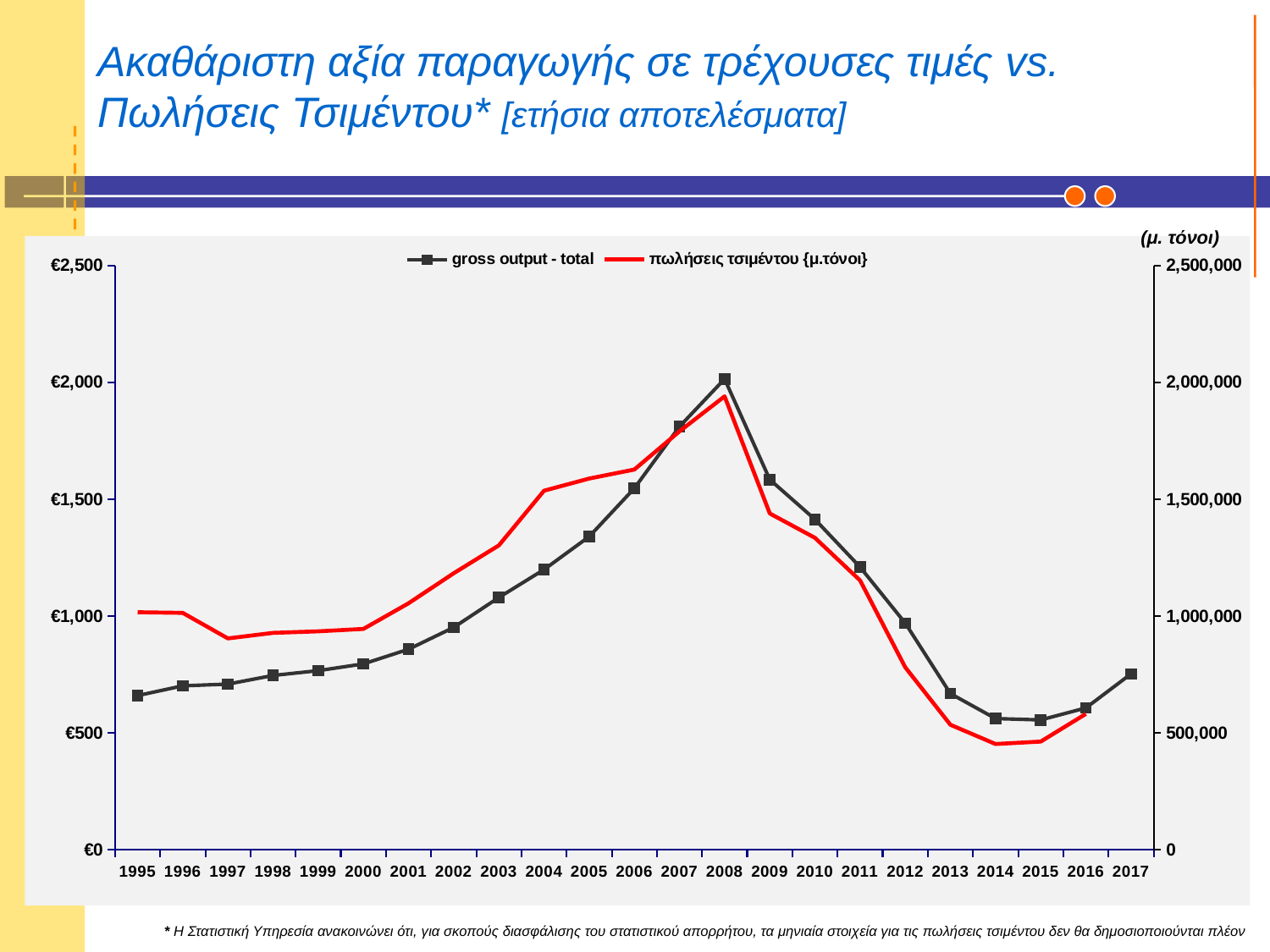
Is the gross output - total value for 1995 greater or less than €1,000? less Is the πωλήσεις τσιμέντου value for 2007 greater or less than 1,500,000? greater How many years are shown on the x axis? 23 What colour is the line for πωλήσεις τσιμέντου? red Which year has the larger gross output - total value, 2008 or 2013? 2008 How many series does the legend list? 2 Is the πωλήσεις τσιμέντου value for 2014 greater or less than 500,000? less What kind of chart is shown on the slide? line chart In which year does the πωλήσεις τσιμέντου series reach its highest value? 2008 Does the gross output - total series rise or fall from 2008 to 2014? fall In which year does the gross output - total series reach its highest value? 2008